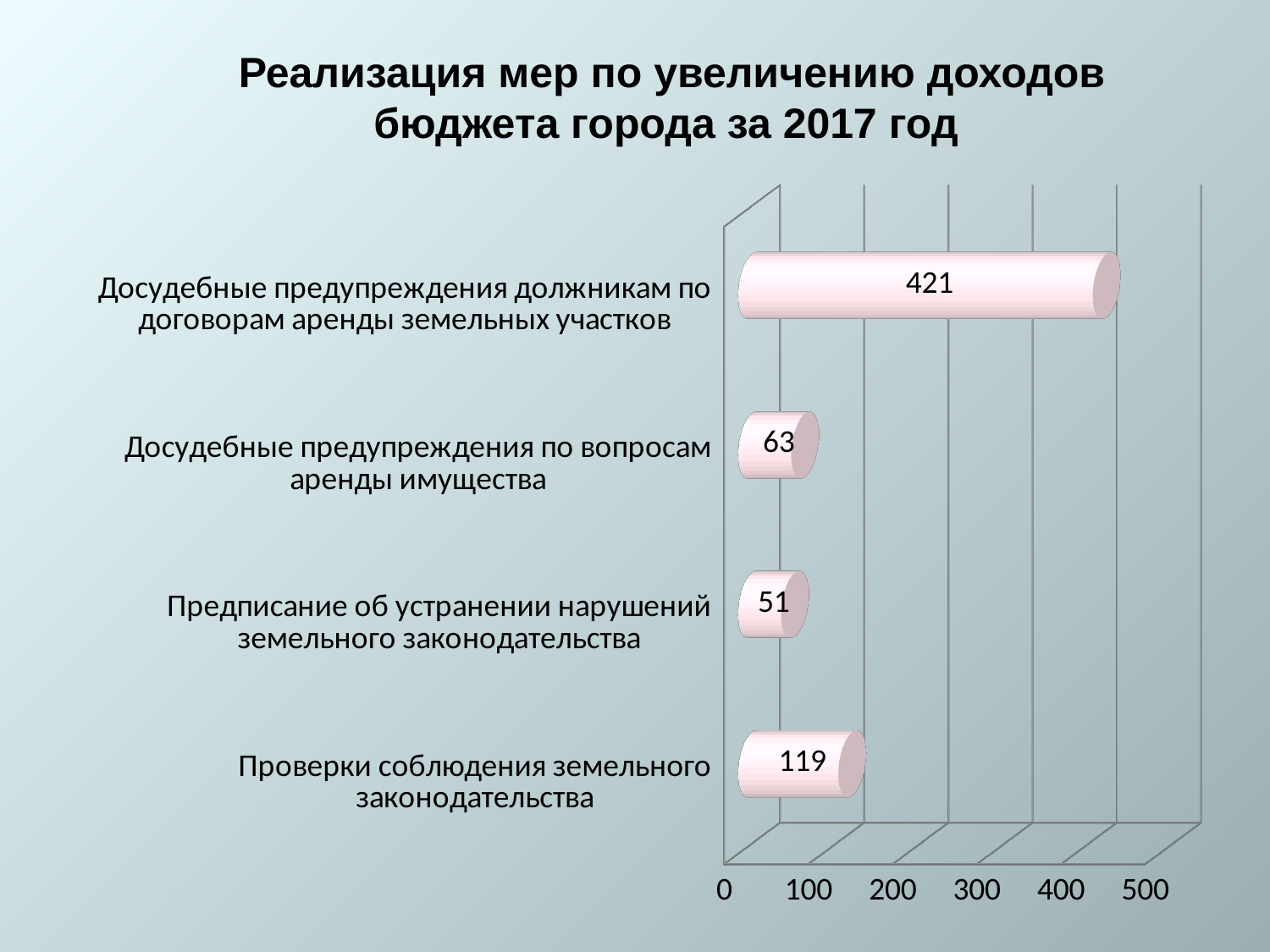
Which is larger: the value for «Проверки соблюдения земельного законодательства» or for «Досудебные предупреждения по вопросам аренды имущества»? Проверки соблюдения земельного законодательства How many categories are shown in the chart? 4 What is the difference between the values for «Досудебные предупреждения должникам по договорам аренды земельных участков» and «Проверки соблюдения земельного законодательства»? 302 Which category has the highest value? Досудебные предупреждения должникам по договорам аренды земельных участков What is the value for «Проверки соблюдения земельного законодательства»? 119 What is the title of the slide? Реализация мер по увеличению доходов бюджета города за 2017 год What kind of chart is shown on the slide? Bar chart What is the difference between the values for «Досудебные предупреждения по вопросам аренды имущества» and «Предписание об устранении нарушений земельного законодательства»? 12 What is the value for «Досудебные предупреждения по вопросам аренды имущества»? 63 Which category has the lowest value? Предписание об устранении нарушений земельного законодательства What is the value for «Досудебные предупреждения должникам по договорам аренды земельных участков»? 421 What is the value for «Предписание об устранении нарушений земельного законодательства»? 51